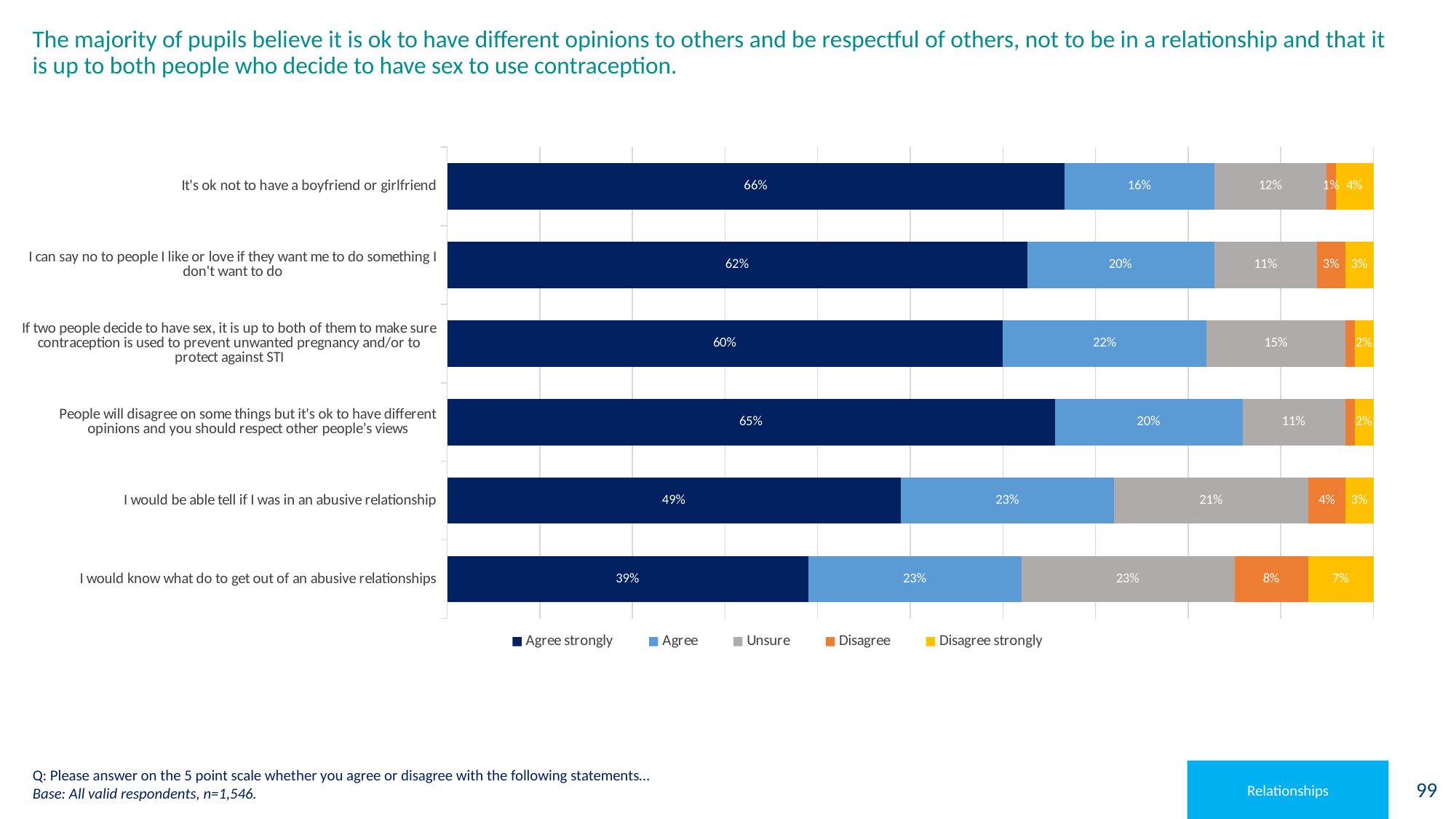
Which is larger: the 'Agree' value for 'If two people decide to have sex, it is up to both of them to make sure contraception is used...' or the 'Agree' value for 'It's ok not to have a boyfriend or girlfriend'? If two people decide to have sex, it is up to both of them to make sure contraception is used... Which statement has the lowest 'Agree strongly' value? I would know what do to get out of an abusive relationships What is the difference between the 'Agree strongly' values for 'It's ok not to have a boyfriend or girlfriend' and 'I would know what do to get out of an abusive relationships'? 27% What is the 'Disagree strongly' value for 'I can say no to people I like or love if they want me to do something I don't want to do'? 3% What is the 'Unsure' value for 'I would be able tell if I was in an abusive relationship'? 21% What percentage of pupils 'Agree strongly' that it's ok not to have a boyfriend or girlfriend? 66% Which legend entry is shown in yellow? Disagree strongly What kind of chart is shown on the slide? Stacked bar chart How many series does the legend list? 5 How many statements (categories) are plotted in the chart? 6 What is the 'Disagree' value for 'I would know what do to get out of an abusive relationships'? 8% Which statement has the highest 'Agree strongly' value? It's ok not to have a boyfriend or girlfriend